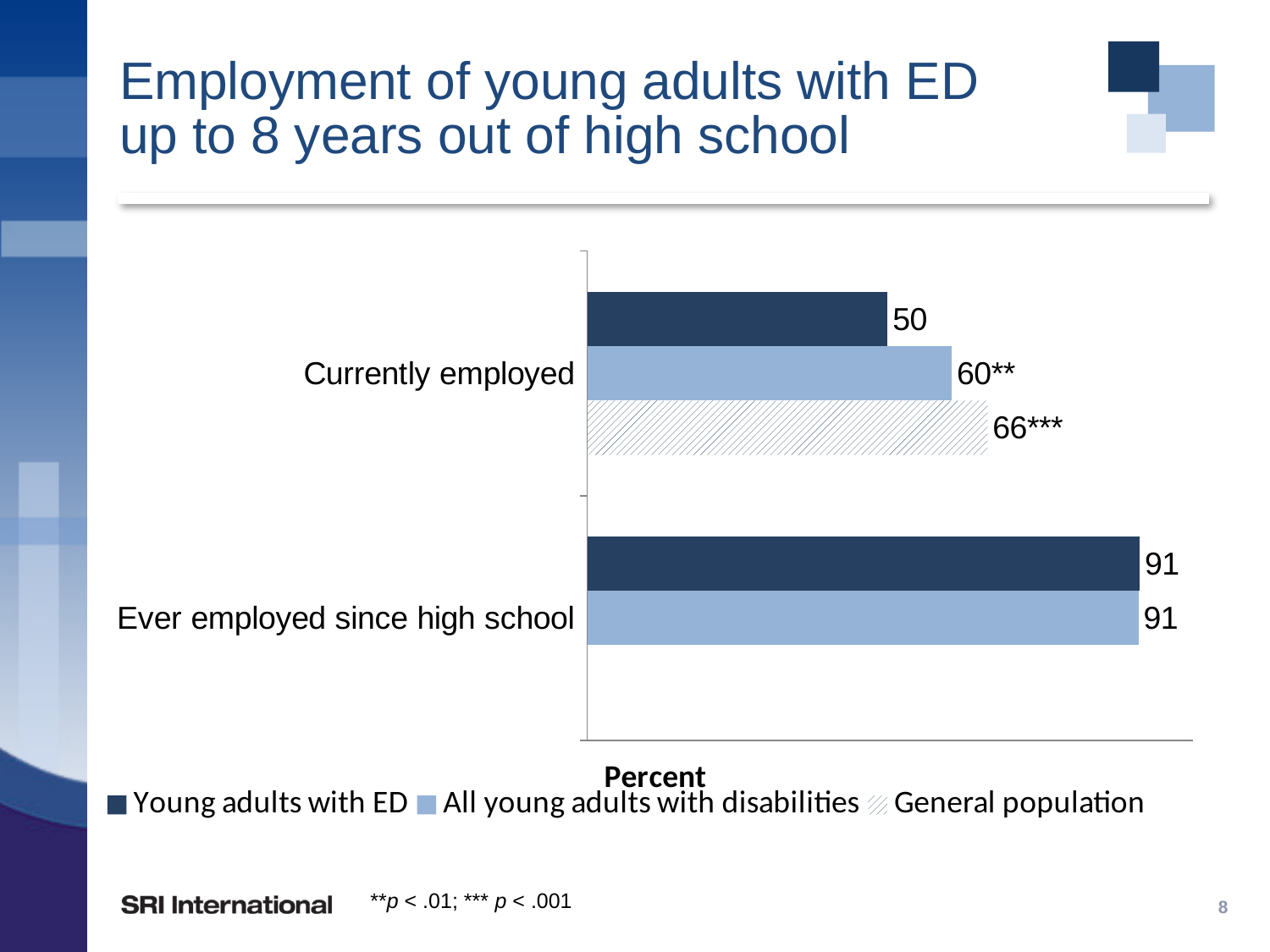
What is the value for Young adults with ED in the Ever employed since high school category? 91 What is the difference between the General population value and the Young adults with ED value for Currently employed? 16 What is the value for Young adults with ED in the Currently employed category? 50 For Currently employed, which is larger: the value for Young adults with ED or the value for All young adults with disabilities? All young adults with disabilities Which series has the lowest value in the Currently employed category? Young adults with ED What is the value for All young adults with disabilities in the Currently employed category? 60** What is the value for General population in the Currently employed category? 66*** Which series has the highest value in the Currently employed category? General population What kind of chart is shown on the slide? Bar chart How many series does the legend list? 3 What is the value for All young adults with disabilities in the Ever employed since high school category? 91 How many categories are shown on the chart? 2